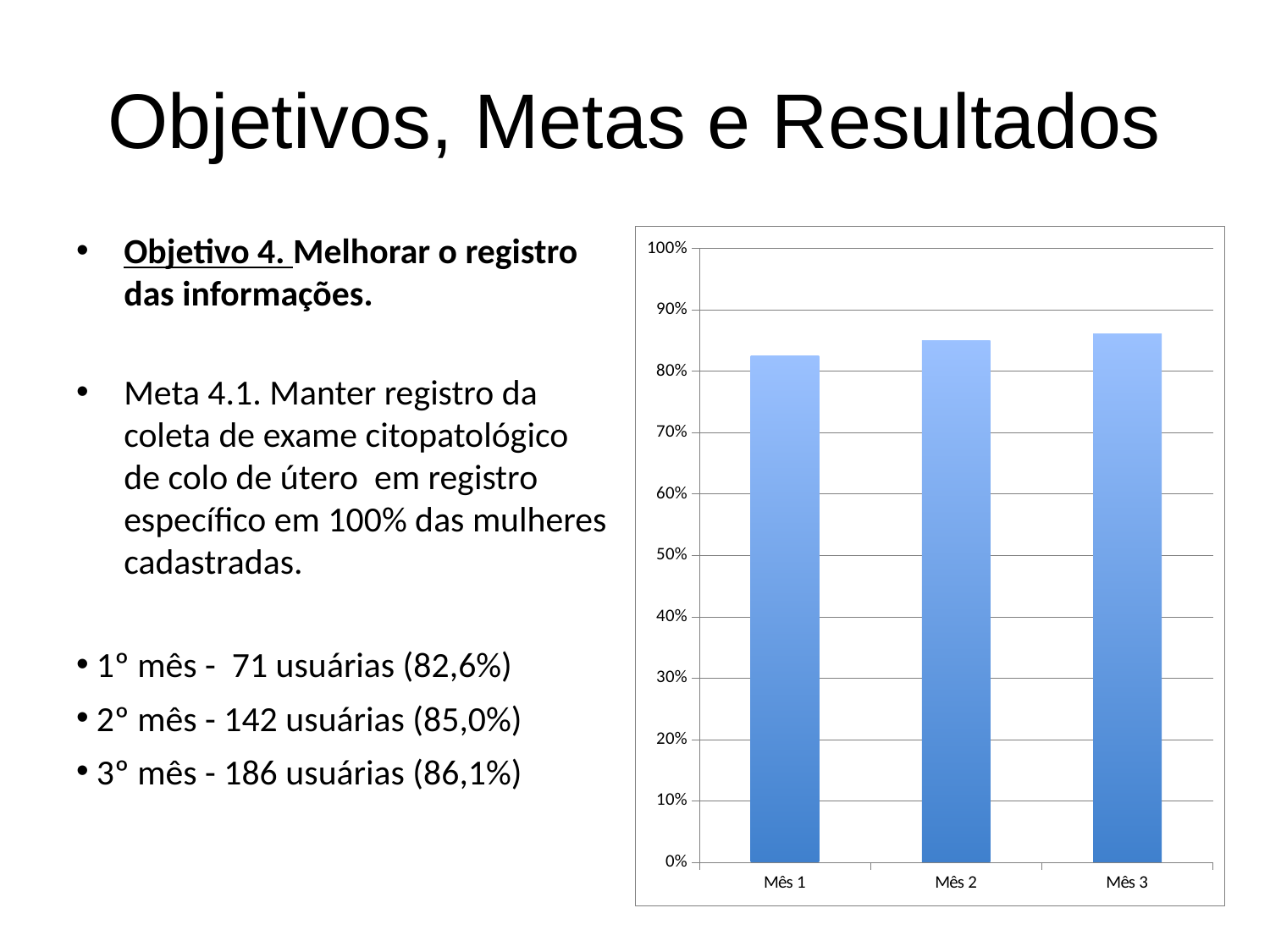
Is the value for Mês 1 greater or less than 90%? less Is the value for Mês 2 greater or less than 80%? greater Is the value for Mês 1 greater or less than 80%? greater Which is larger, the value for Mês 1 or the value for Mês 2? Mês 2 What is the highest value shown on the chart's y axis? 100% According to the slide text, what percentage corresponds to the 1º mês? 82,6% Which month has the lowest bar in the chart? Mês 1 What kind of chart is shown on the slide? bar chart Do the values rise or fall from Mês 1 to Mês 3? rise How many categories are shown on the x axis of the chart? 3 According to the slide text, what percentage corresponds to the 3º mês? 86,1%